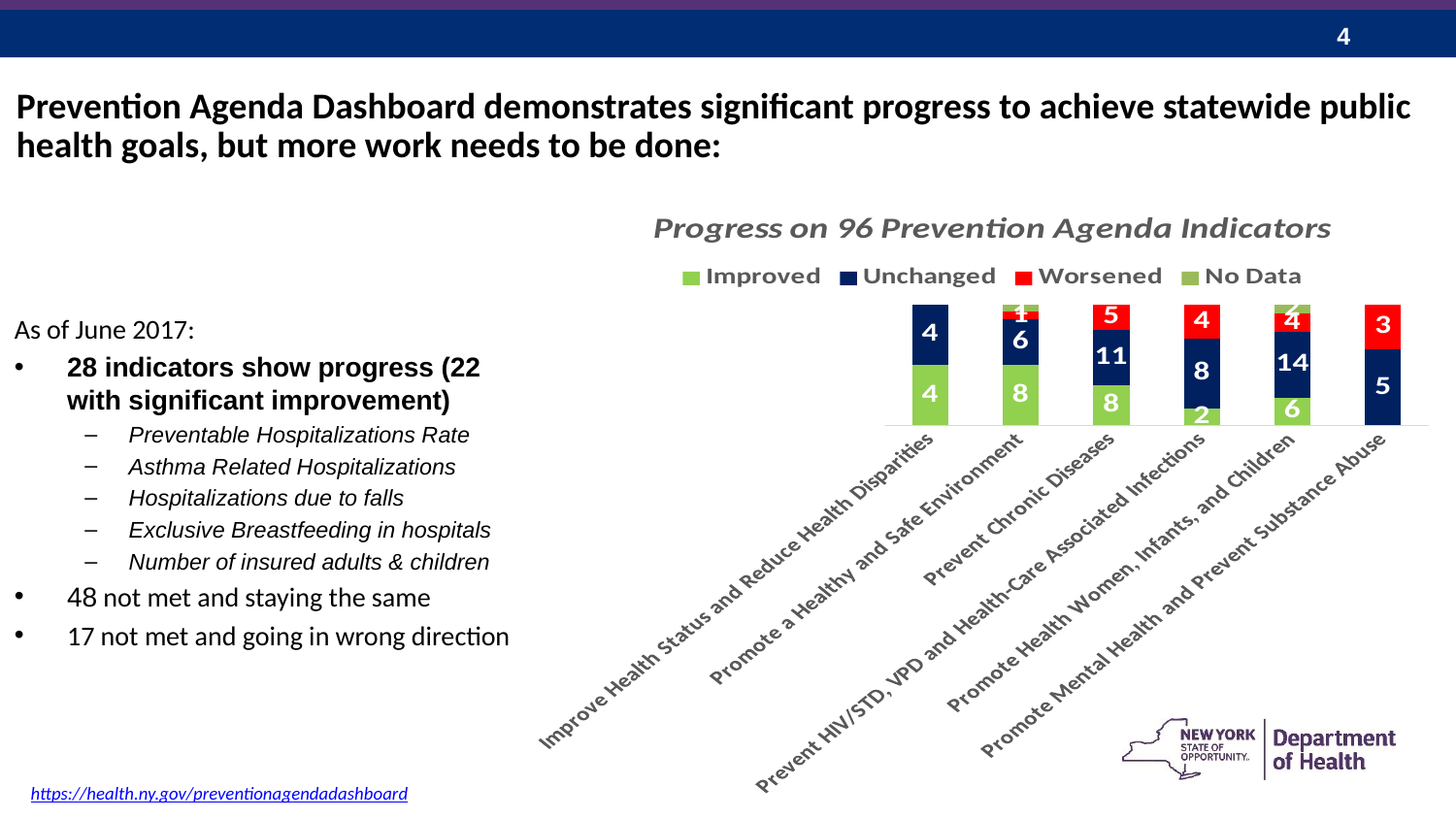
How many series does the chart legend list? 4 What is the title of the chart? Progress on 96 Prevention Agenda Indicators What is the Unchanged value for Prevent Chronic Diseases? 11 What is the total of the stacked bar for Prevent Chronic Diseases? 24 What is the Worsened value for Promote Mental Health and Prevent Substance Abuse? 3 What kind of chart is shown on the slide? Stacked bar chart What is the Improved value for Prevent HIV/STD, VPD and Health-Care Associated Infections? 2 Which category has the highest Unchanged value? Promote Health Women, Infants, and Children What is the difference between the Unchanged and Improved values for Prevent HIV/STD, VPD and Health-Care Associated Infections? 6 Which is larger, the Improved value for Prevent Chronic Diseases or the Improved value for Improve Health Status and Reduce Health Disparities? Prevent Chronic Diseases How many categories are shown along the x axis of the chart? 6 What is the Improved value for Prevent Chronic Diseases? 8